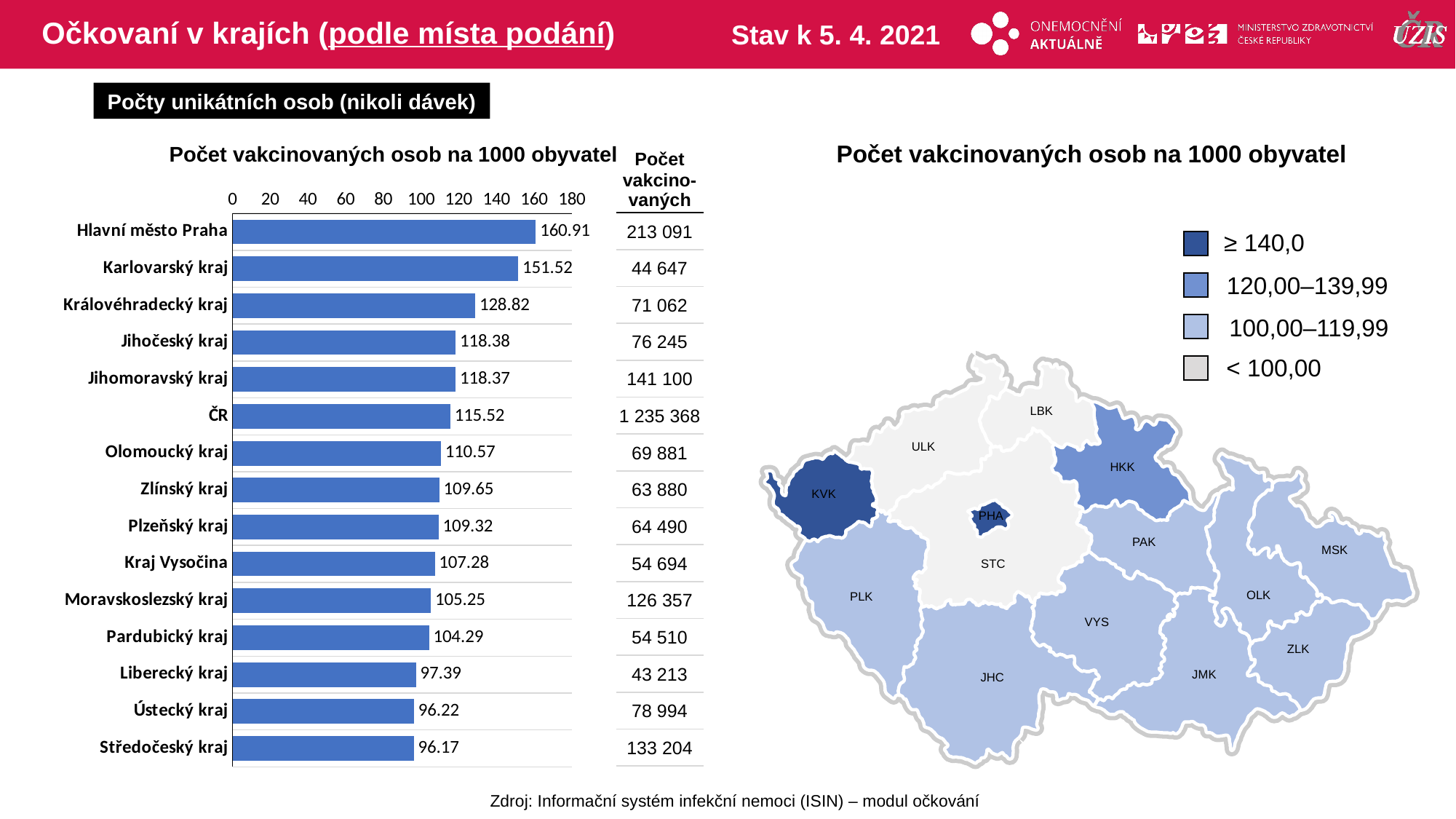
In the bar chart, which category has the highest value? Hlavní město Praha What kind of chart is shown on the left side of the slide? bar chart In the bar chart, what is the value for Kraj Vysočina? 107.28 In the bar chart, which has a larger value, Královéhradecký kraj or Olomoucký kraj? Královéhradecký kraj In the bar chart, what is the value for ČR? 115.52 In the bar chart, is the value for Liberecký kraj greater or less than 100? less In the bar chart, what is the value for Karlovarský kraj? 151.52 How many categories (bars) does the bar chart show? 15 In the bar chart, what is the difference between the values for ČR and Středočeský kraj? 19.35 In the bar chart, which category has the lowest value? Středočeský kraj In the bar chart, what is the difference between the values for Hlavní město Praha and Karlovarský kraj? 9.39 In the bar chart, what is the value for Hlavní město Praha? 160.91